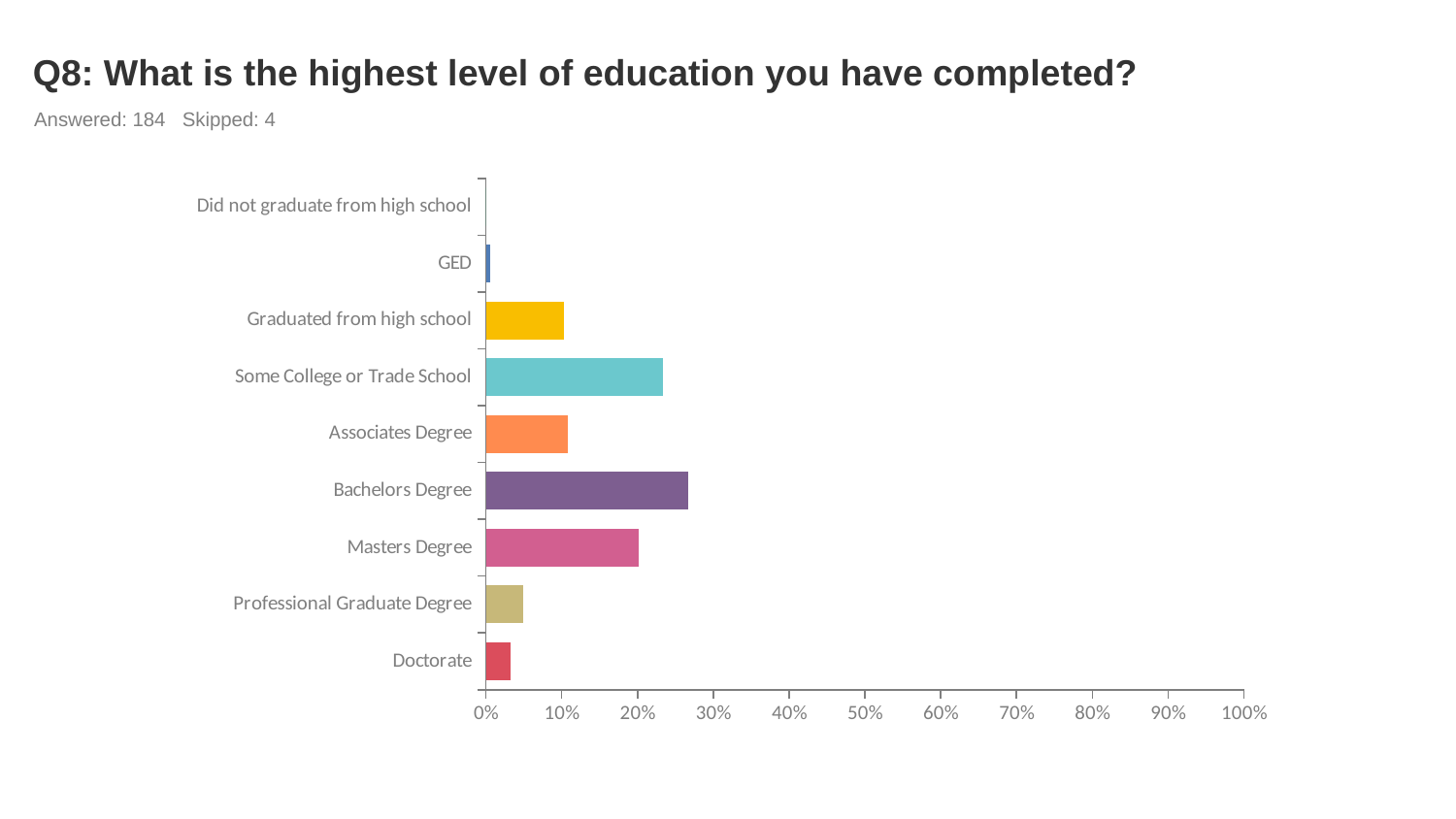
What is the title of the chart? Q8: What is the highest level of education you have completed? What kind of chart is shown on the slide? bar chart Is the value for Bachelors Degree greater or less than 20%? greater Is the value for Professional Graduate Degree greater or less than 10%? less Is the value for Doctorate greater or less than 10%? less Which is larger, the value for Some College or Trade School or the value for Associates Degree? Some College or Trade School Which education category has the highest value? Bachelors Degree Which is larger, the value for Bachelors Degree or the value for Masters Degree? Bachelors Degree How many education categories are plotted on the chart? 9 Which education category has the lowest value? Did not graduate from high school